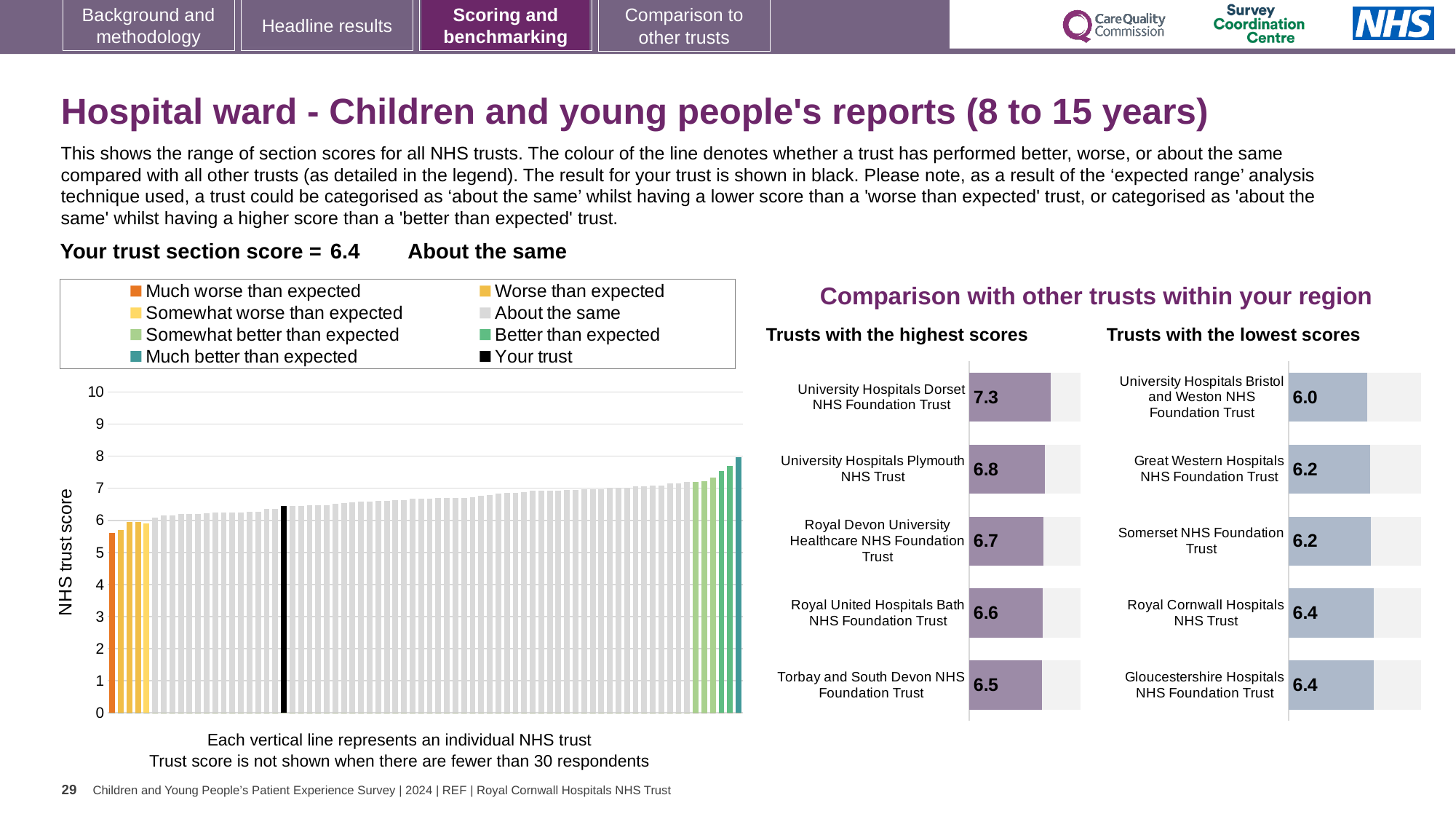
In the chart on the left showing all NHS trusts, do the bar values rise or fall from left to right? rise In the chart on the left showing all NHS trusts, is the value of the black bar (your trust) greater or less than 6? greater In the 'Trusts with the highest scores' chart, which trust has the lowest score? Torbay and South Devon NHS Foundation Trust In the chart on the left showing all NHS trusts, what kind of chart is it? bar chart In the chart on the left showing all NHS trusts, how many entries does the legend list? 8 In the 'Trusts with the lowest scores' chart, how many trusts are shown? 5 In the 'Trusts with the highest scores' chart, what is the score for University Hospitals Dorset NHS Foundation Trust? 7.3 In the chart on the left showing all NHS trusts, is the value of the leftmost (lowest) bar greater or less than 5? greater In the 'Trusts with the lowest scores' chart, which trust has the lowest score? University Hospitals Bristol and Weston NHS Foundation Trust In the 'Trusts with the highest scores' chart, what is the difference between the scores of University Hospitals Dorset NHS Foundation Trust and Torbay and South Devon NHS Foundation Trust? 0.8 In the chart on the left showing all NHS trusts, what is the label on the vertical axis? NHS trust score In the 'Trusts with the lowest scores' chart, which has the larger score: Somerset NHS Foundation Trust or Royal Cornwall Hospitals NHS Trust? Royal Cornwall Hospitals NHS Trust